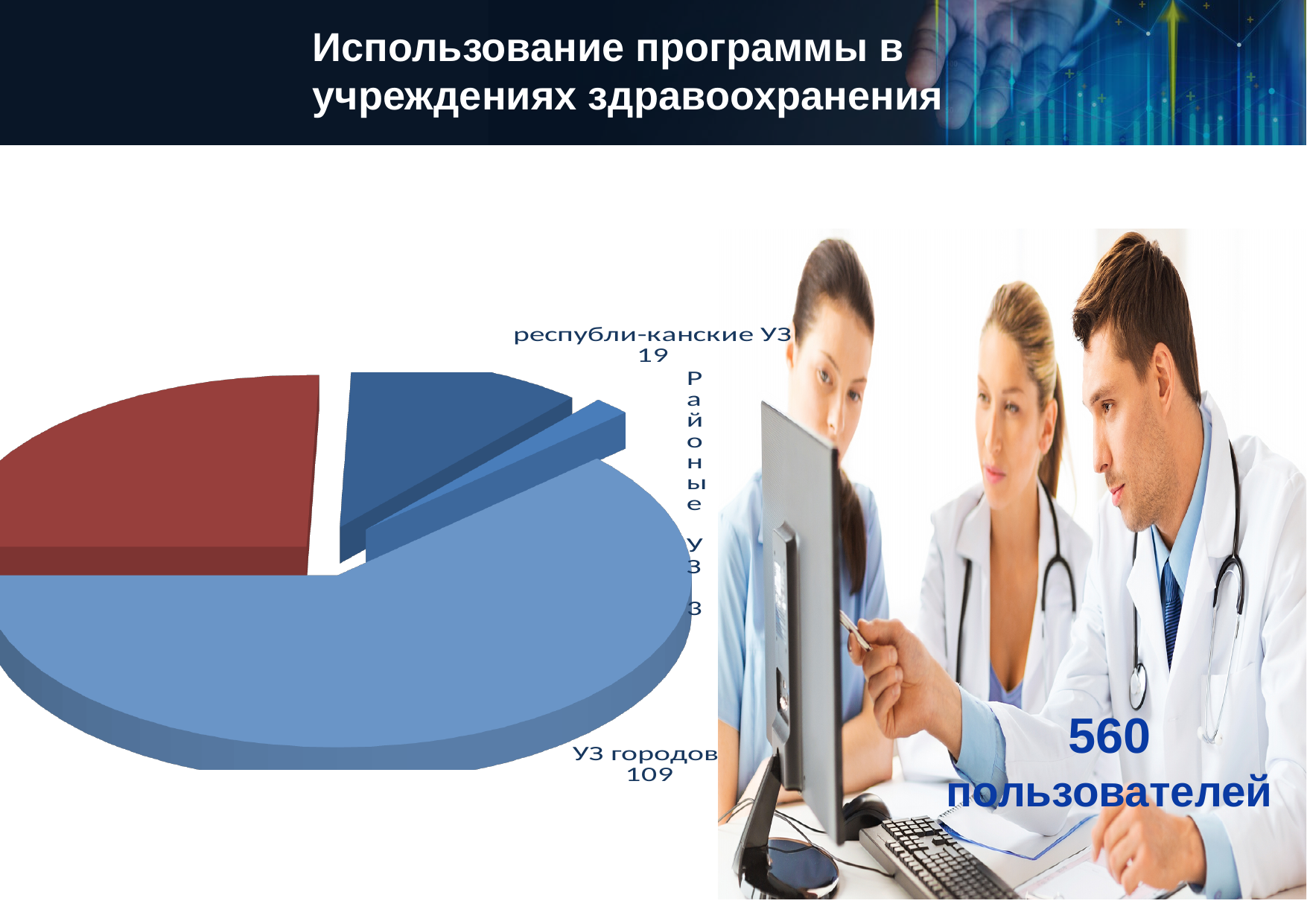
How many slices does the pie chart have? 4 What kind of chart is shown on the slide? pie chart Which labelled slice of the pie chart is the largest? УЗ городов What is the difference between the value for УЗ городов and the value for республиканские УЗ? 90 Which is larger, the value for УЗ городов or the value for республиканские УЗ? УЗ городов What is the value for УЗ городов in the pie chart? 109 What colour is the largest slice of the pie chart? light blue What is the title of the slide containing the pie chart? Использование программы в учреждениях здравоохранения What is the value for республиканские УЗ in the pie chart? 19